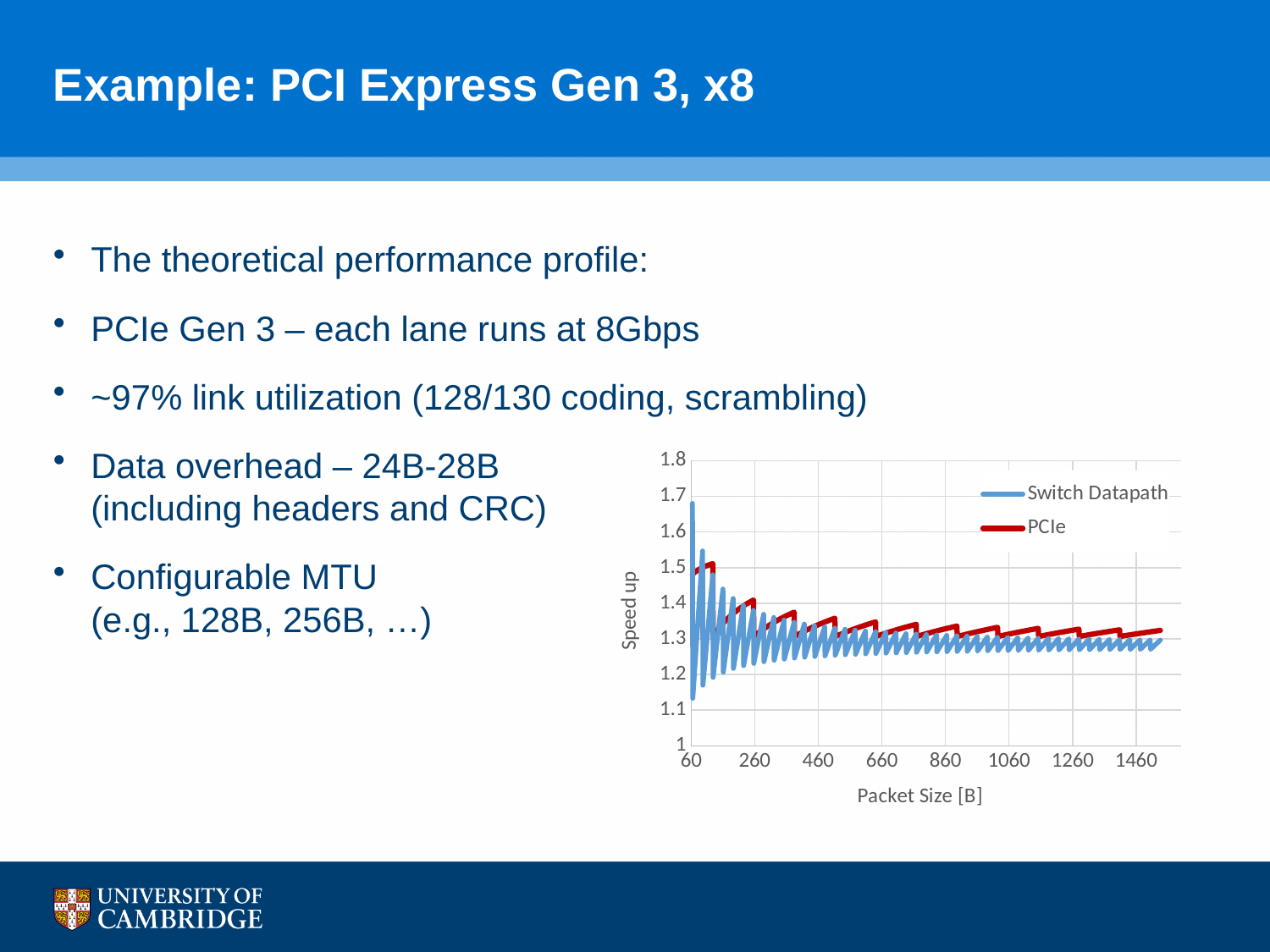
Which series reaches the highest speed up value on the chart? Switch Datapath What kind of chart is shown on the slide? line chart Is the PCIe speed up at a packet size of 1460 B greater or less than 1.2? greater What is the label of the chart's x axis? Packet Size [B] What is the highest value shown on the chart's y axis (Speed up)? 1.8 Is the PCIe speed up at a packet size of 1460 B greater or less than 1.4? less Is the peak value of the Switch Datapath series greater or less than 1.5? greater Overall, do the PCIe speed up values rise or fall as packet size increases along the x axis? fall At large packet sizes (around 1460 B), which series has the higher speed up, Switch Datapath or PCIe? PCIe How many series does the chart's legend list? 2 What are the two series named in the chart's legend? Switch Datapath and PCIe